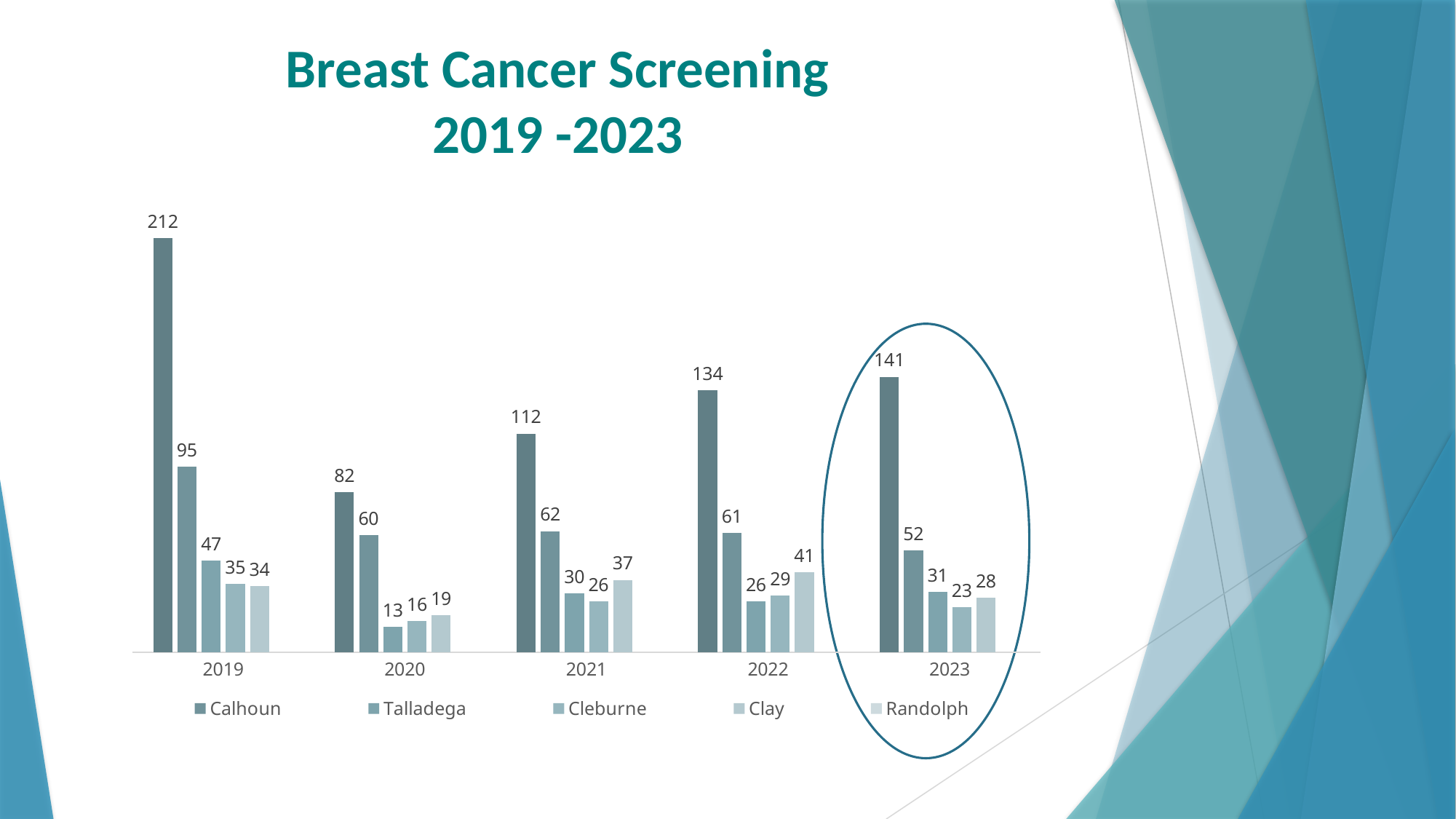
What is the value for Cleburne in 2020? 13 What is the value for Randolph in 2022? 41 Which year has the lowest value for Talladega? 2023 Which is larger, the Clay value in 2021 or the Clay value in 2022? 2022 What kind of chart is shown on the slide? bar chart Which year has the highest value for Calhoun? 2019 What is the value for Calhoun in 2019? 212 What is the difference between the Calhoun values in 2019 and 2020? 130 How many years are shown on the x axis? 5 How many series does the legend list? 5 What is the title of the chart? Breast Cancer Screening 2019 -2023 Does the Calhoun value rise or fall from 2019 to 2020? fall